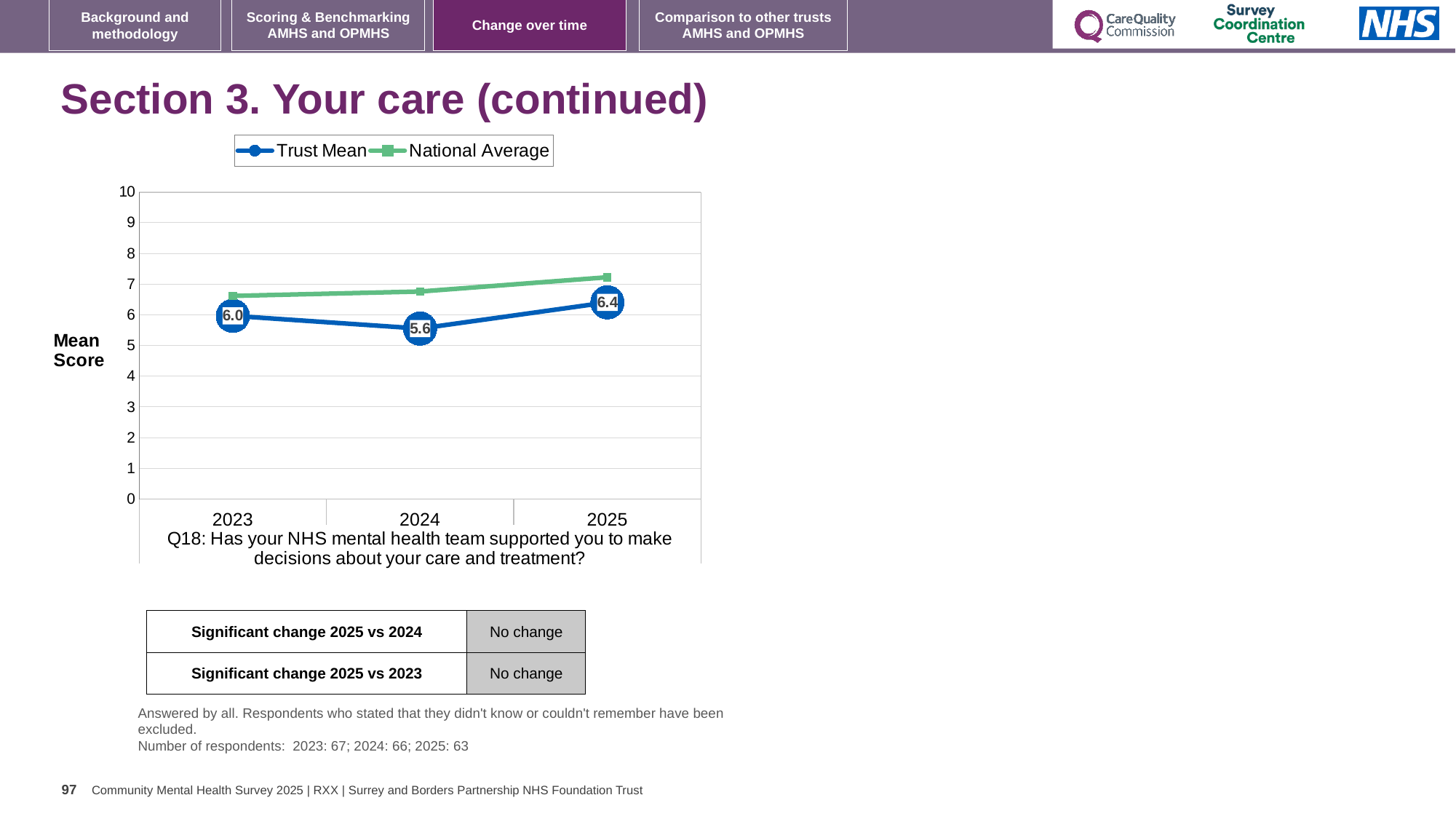
In which year is the Trust Mean score highest? 2025 How many series does the legend list? 2 Is the National Average value for 2023 greater or less than 6? greater How many years are shown on the x axis? 3 In 2024, which is higher: the Trust Mean or the National Average? National Average What is the Trust Mean score for 2024? 5.6 In which year is the Trust Mean score lowest? 2024 What is the Trust Mean score for 2025? 6.4 What kind of chart is shown on the slide? Line chart Does the Trust Mean rise or fall from 2024 to 2025? Rise What is the Trust Mean score for 2023? 6.0 What is the difference between the Trust Mean scores for 2025 and 2024? 0.8